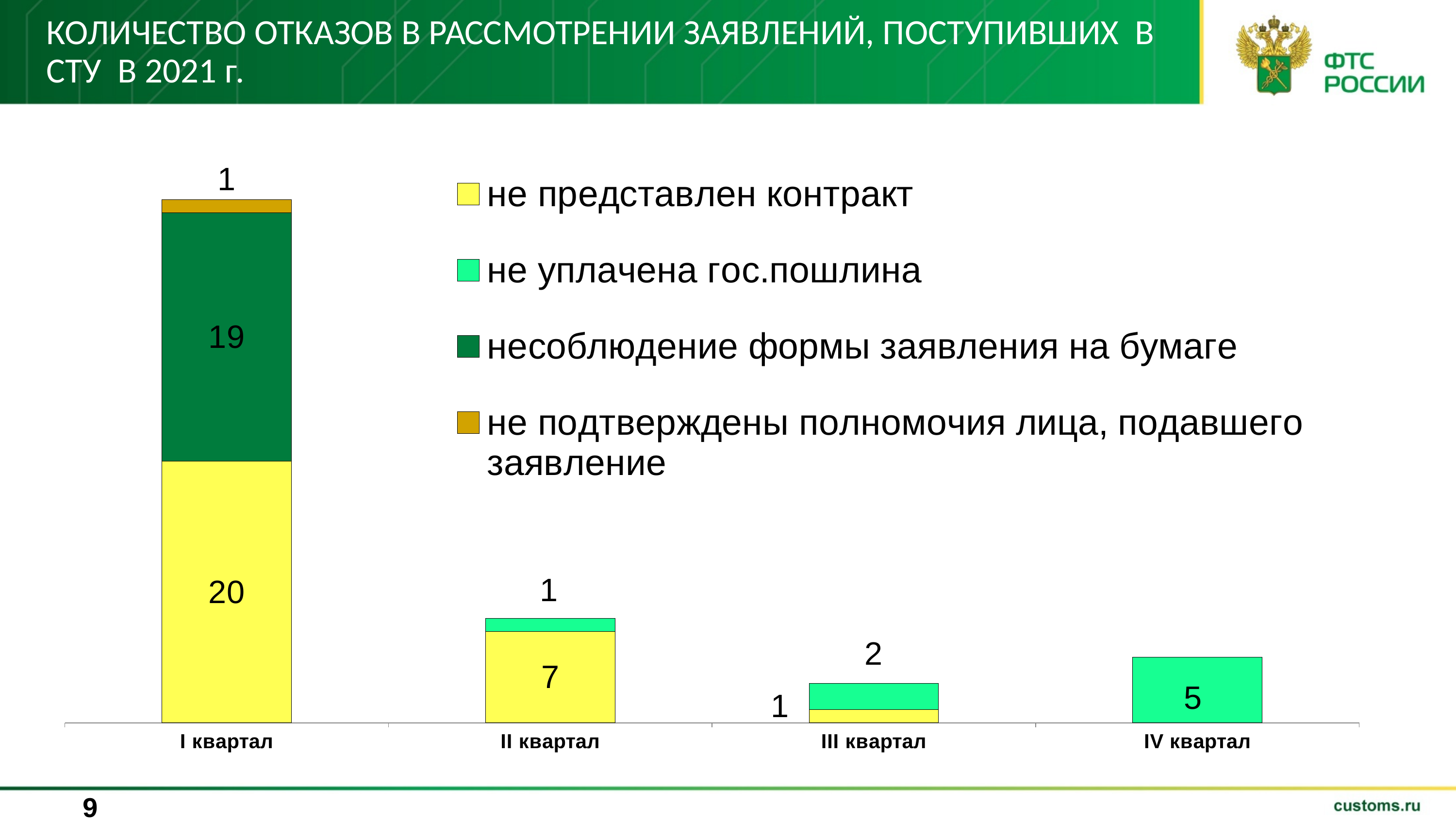
What type of chart is shown on the slide? stacked bar chart What is the total of the stacked bar for I квартал? 40 What is the value for "несоблюдение формы заявления на бумаге" in I квартал? 19 Which quarter has the highest total number of refusals? I квартал What is the total of the stacked bar for II квартал? 8 What is the difference between the "не представлен контракт" values for I квартал and II квартал? 13 How many series does the legend list? 4 What is the value for "не уплачена гос.пошлина" in III квартал? 2 How many quarters (categories) are shown on the x axis? 4 What is the value for "не представлен контракт" in II квартал? 7 What is the value for "не представлен контракт" in I квартал? 20 What is the value for "не уплачена гос.пошлина" in IV квартал? 5